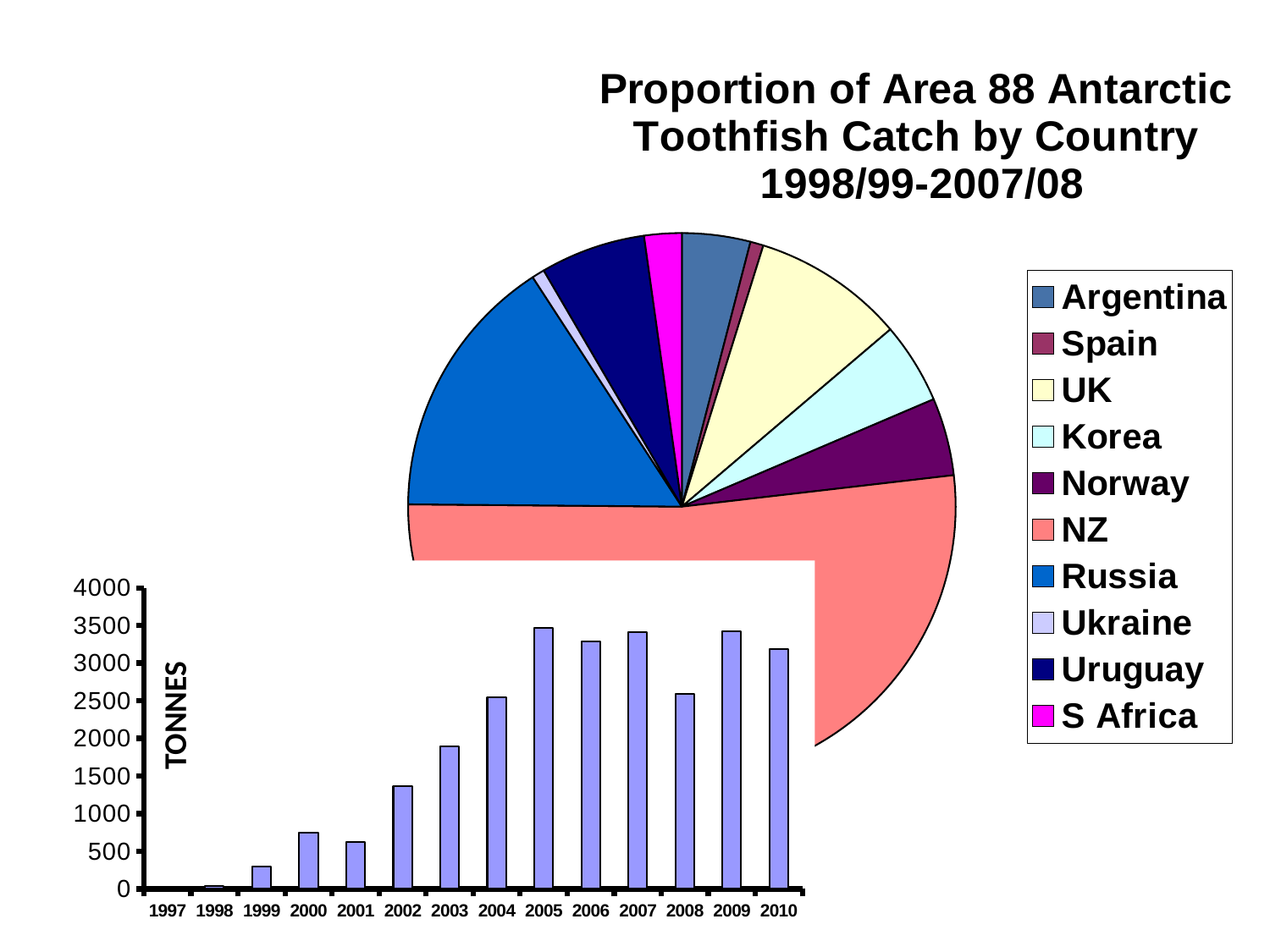
In the pie chart, how many countries does the legend list? 10 In the bar chart at the bottom left, is the value for 2010 greater or less than 3000? greater In the bar chart at the bottom left, is the value for 2002 greater or less than 1500? less In the pie chart, which slice is larger, Uruguay or S Africa? Uruguay What kind of chart is the chart titled 'Proportion of Area 88 Antarctic Toothfish Catch by Country 1998/99-2007/08'? pie chart What kind of chart is the chart at the bottom left of the slide? bar chart In the bar chart at the bottom left, which year has the larger value, 2008 or 2009? 2009 In the pie chart, which slice is larger, Russia or UK? Russia In the pie chart, which country has the largest slice? NZ In the bar chart at the bottom left, is the value for 1999 greater or less than 500? less What is the label on the vertical axis of the bar chart at the bottom left? TONNES In the bar chart at the bottom left, how many years are shown on the x axis? 14